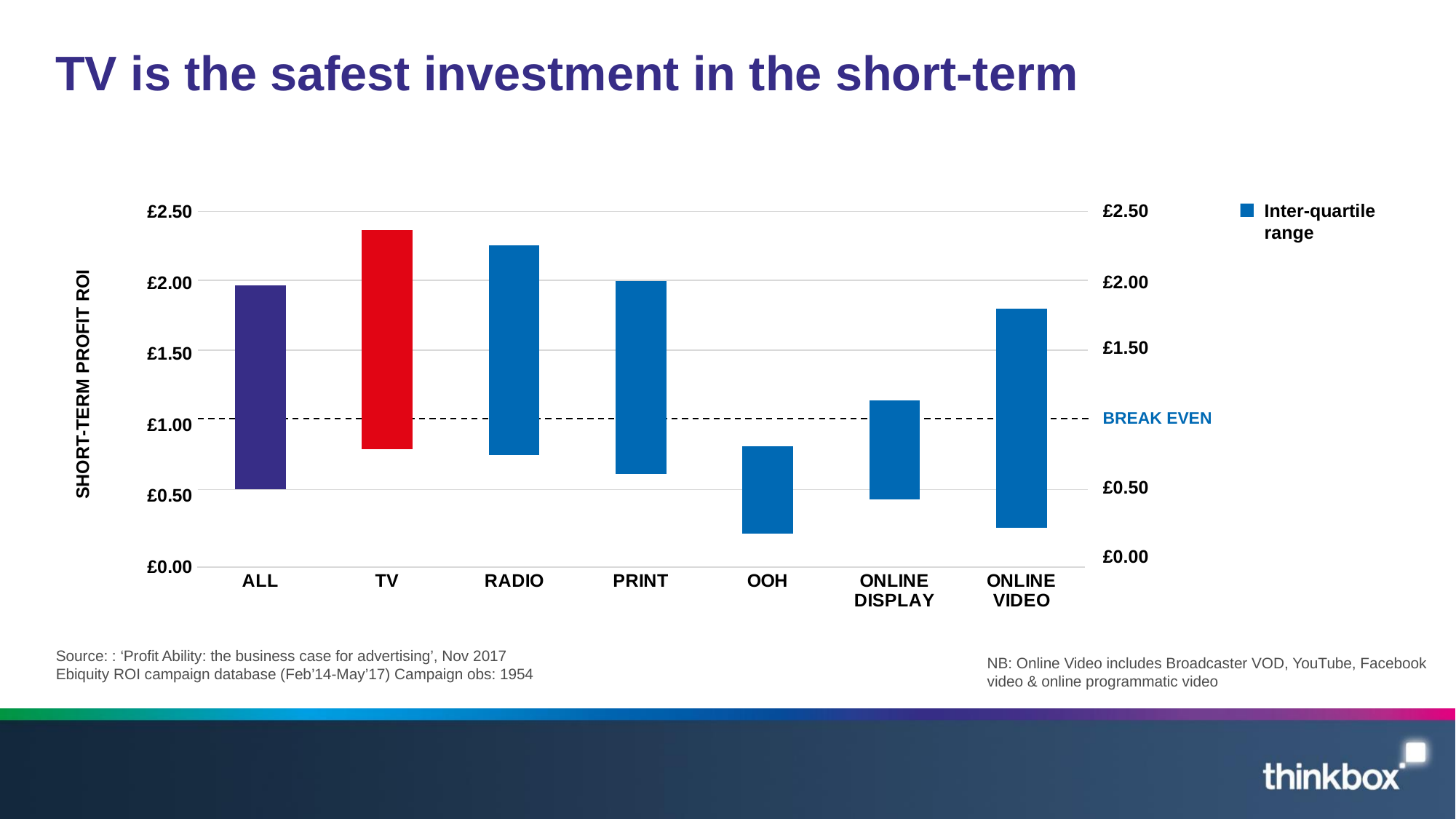
Is the top of the ONLINE DISPLAY inter-quartile range greater or less than £1.00? greater How many categories are shown on the x axis of the chart? 7 What colour is the TV bar on the chart? Red Which reaches a higher top value, the RADIO range or the PRINT range? RADIO Is the top of the TV inter-quartile range greater or less than £2.00? greater What kind of chart is shown on the slide? Bar chart How many series does the chart's legend list? 1 What does the dashed horizontal line on the chart represent? Break even Which category's inter-quartile range reaches the highest value on the chart? TV Is the bottom of the PRINT inter-quartile range greater or less than £0.50? greater